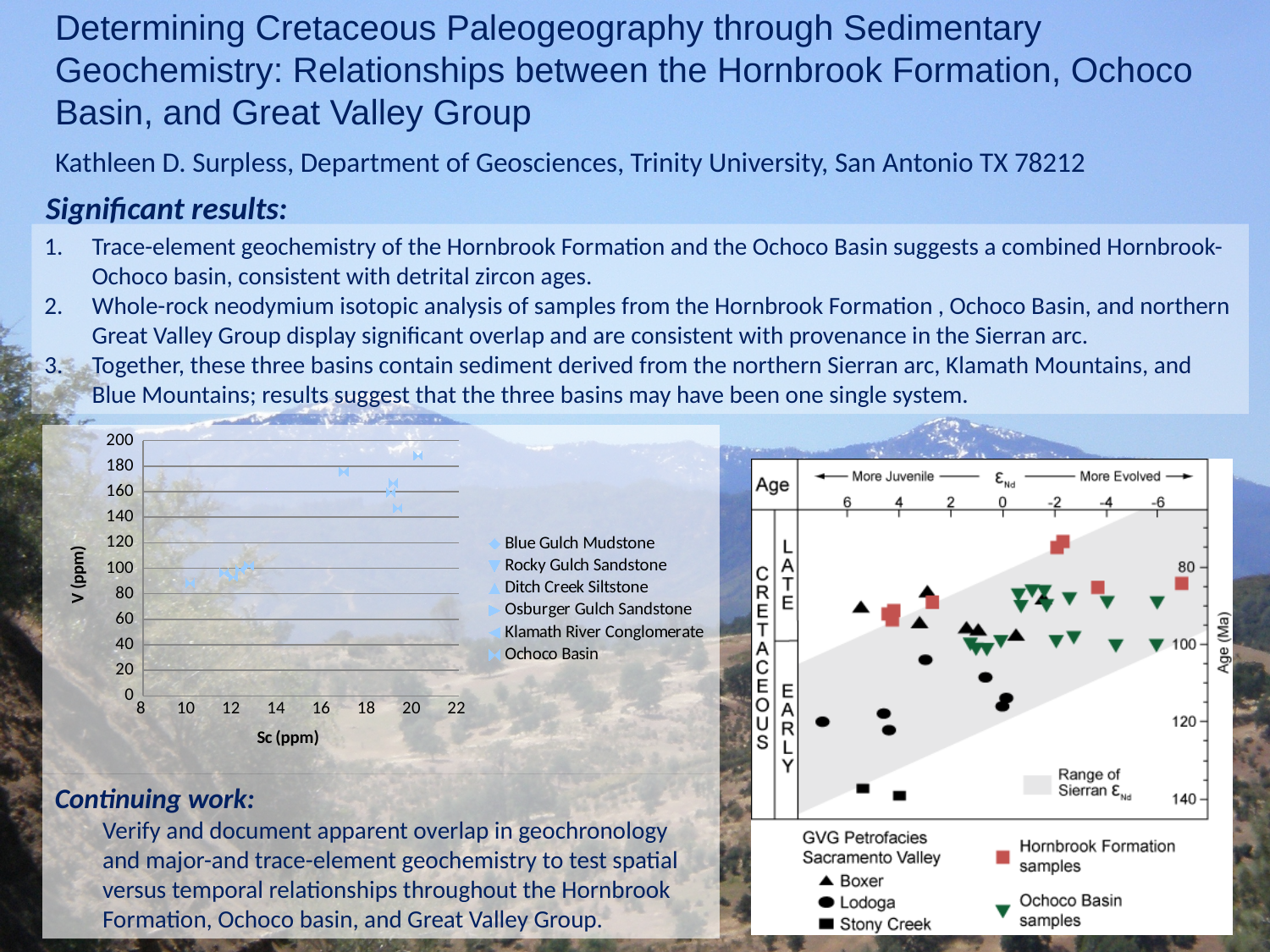
On the left V (ppm) versus Sc (ppm) chart, what is the title of the x axis? Sc (ppm) On the left V (ppm) versus Sc (ppm) chart, do the V values generally rise or fall as Sc increases? rise What kind of chart is the V (ppm) versus Sc (ppm) chart on the left of the slide? scatter chart How many sample groups does the legend of the εNd versus Age chart on the right list? 5 On the left V (ppm) versus Sc (ppm) chart, is the lowest plotted V value greater or less than 100? less How many series does the legend of the left V (ppm) versus Sc (ppm) chart list? 6 On the left V (ppm) versus Sc (ppm) chart, what is the title of the y axis? V (ppm) On the left V (ppm) versus Sc (ppm) chart, is the highest plotted V value greater or less than 180? greater